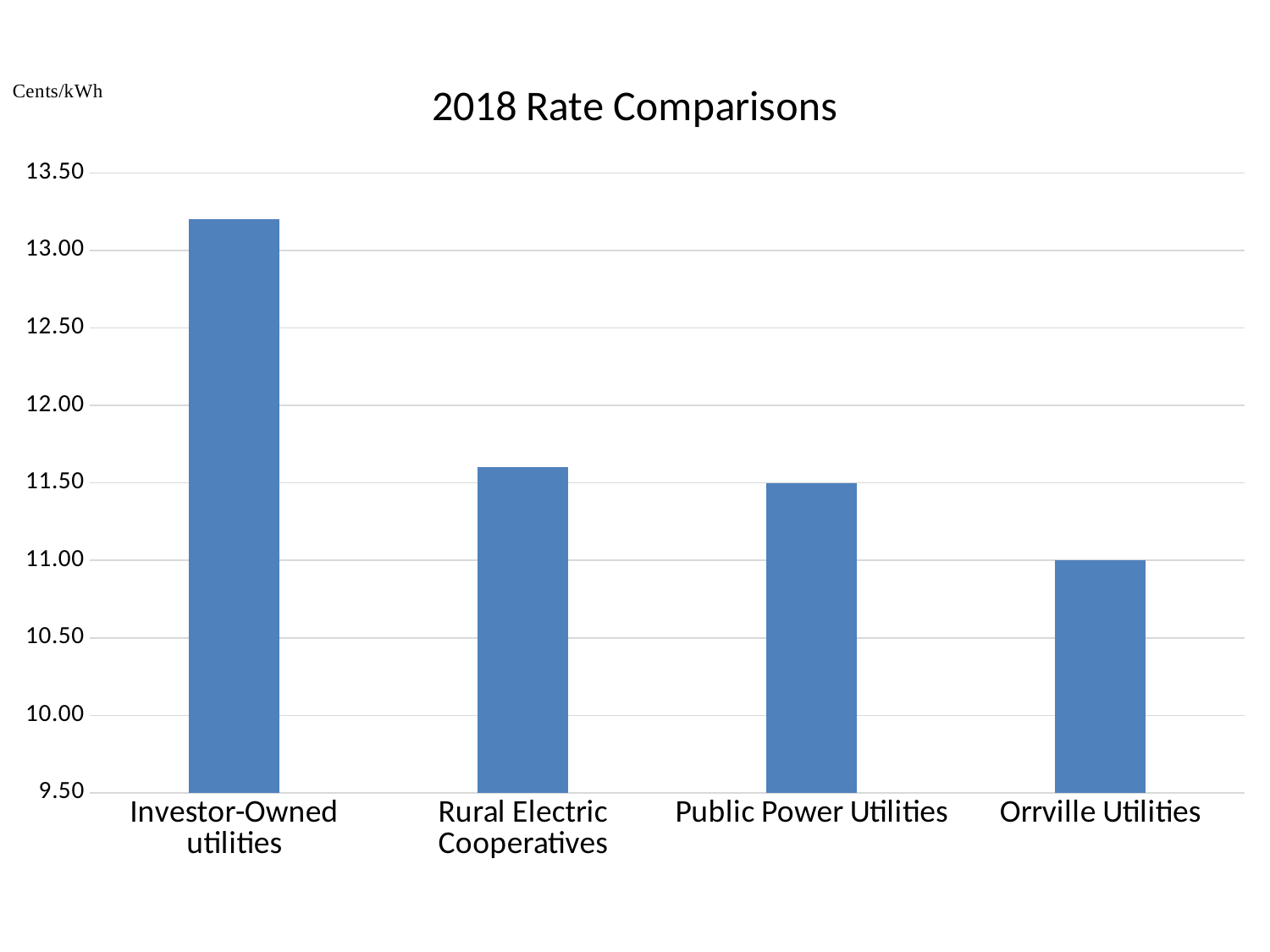
Which is larger, the value for Investor-Owned utilities or the value for Rural Electric Cooperatives? Investor-Owned utilities What unit is shown for the values on the chart? Cents/kWh Is the value for Orrville Utilities greater or less than 11.50? less Is the value for Investor-Owned utilities greater or less than 13.00? greater Which category has the lowest rate? Orrville Utilities Which category has the highest rate? Investor-Owned utilities Is the value for Public Power Utilities greater or less than 12.00? less What is the title of the chart? 2018 Rate Comparisons How many categories are plotted in the chart? 4 What type of chart is shown on the slide? bar chart Which is larger, the value for Public Power Utilities or the value for Orrville Utilities? Public Power Utilities